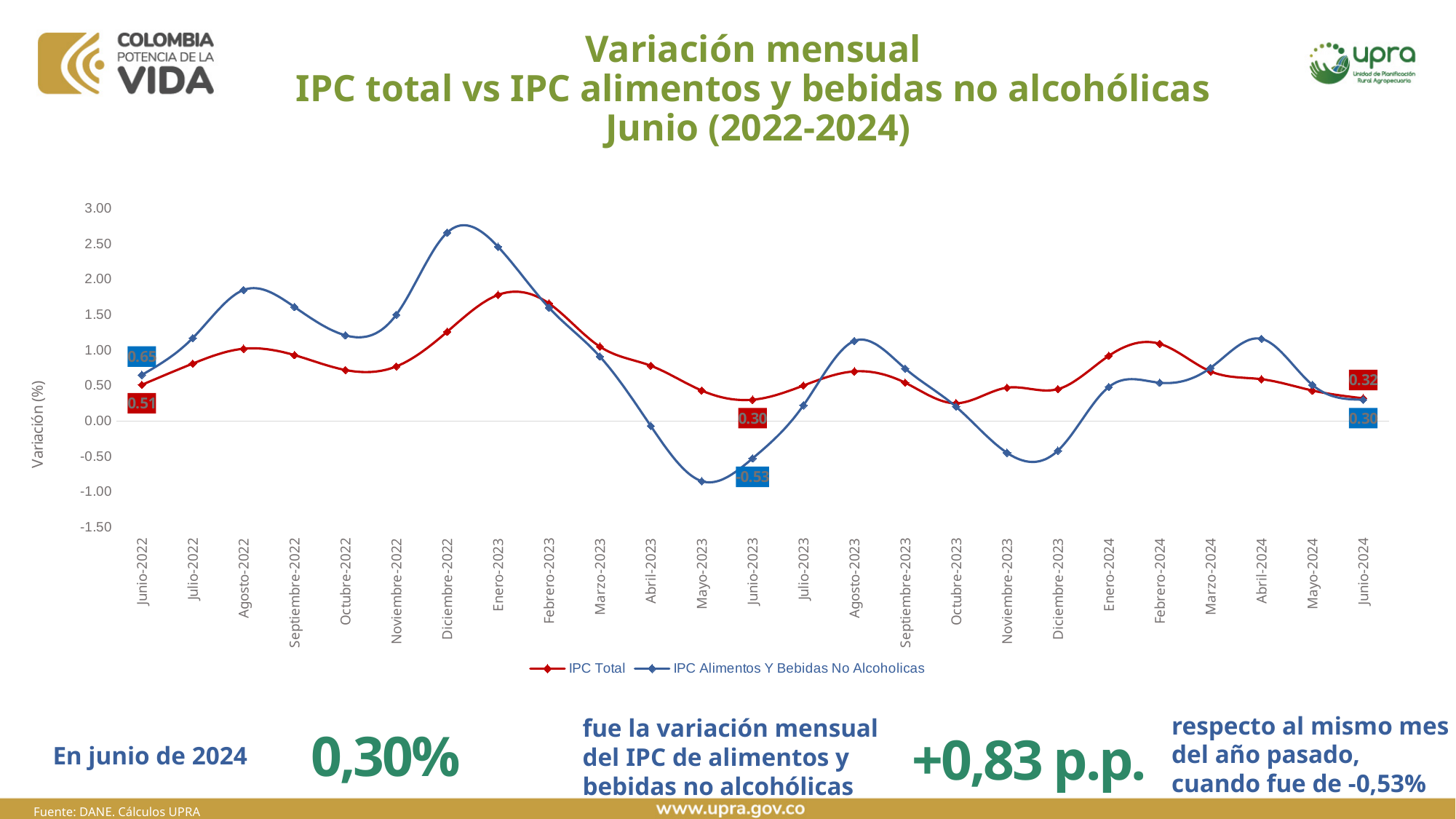
What is the value of IPC Total for Junio-2022? 0.51 In Junio-2023, what is the difference between the IPC Total value and the IPC Alimentos Y Bebidas No Alcoholicas value? 0.83 Is the value of IPC Alimentos Y Bebidas No Alcoholicas for Mayo-2023 greater or less than -0.50? less How many series does the legend list? 2 Is the value of IPC Alimentos Y Bebidas No Alcoholicas for Diciembre-2022 greater or less than 2.50? greater What is the value of IPC Total for Junio-2024? 0.32 In Junio-2023, which series has the higher value, IPC Total or IPC Alimentos Y Bebidas No Alcoholicas? IPC Total In which month does IPC Alimentos Y Bebidas No Alcoholicas reach its lowest value? Mayo-2023 What kind of chart is shown on the slide? line chart In Junio-2022, what is the difference between the IPC Alimentos Y Bebidas No Alcoholicas value and the IPC Total value? 0.14 What is the value of IPC Alimentos Y Bebidas No Alcoholicas for Junio-2023? -0.53 What is the value of IPC Alimentos Y Bebidas No Alcoholicas for Junio-2024? 0.30